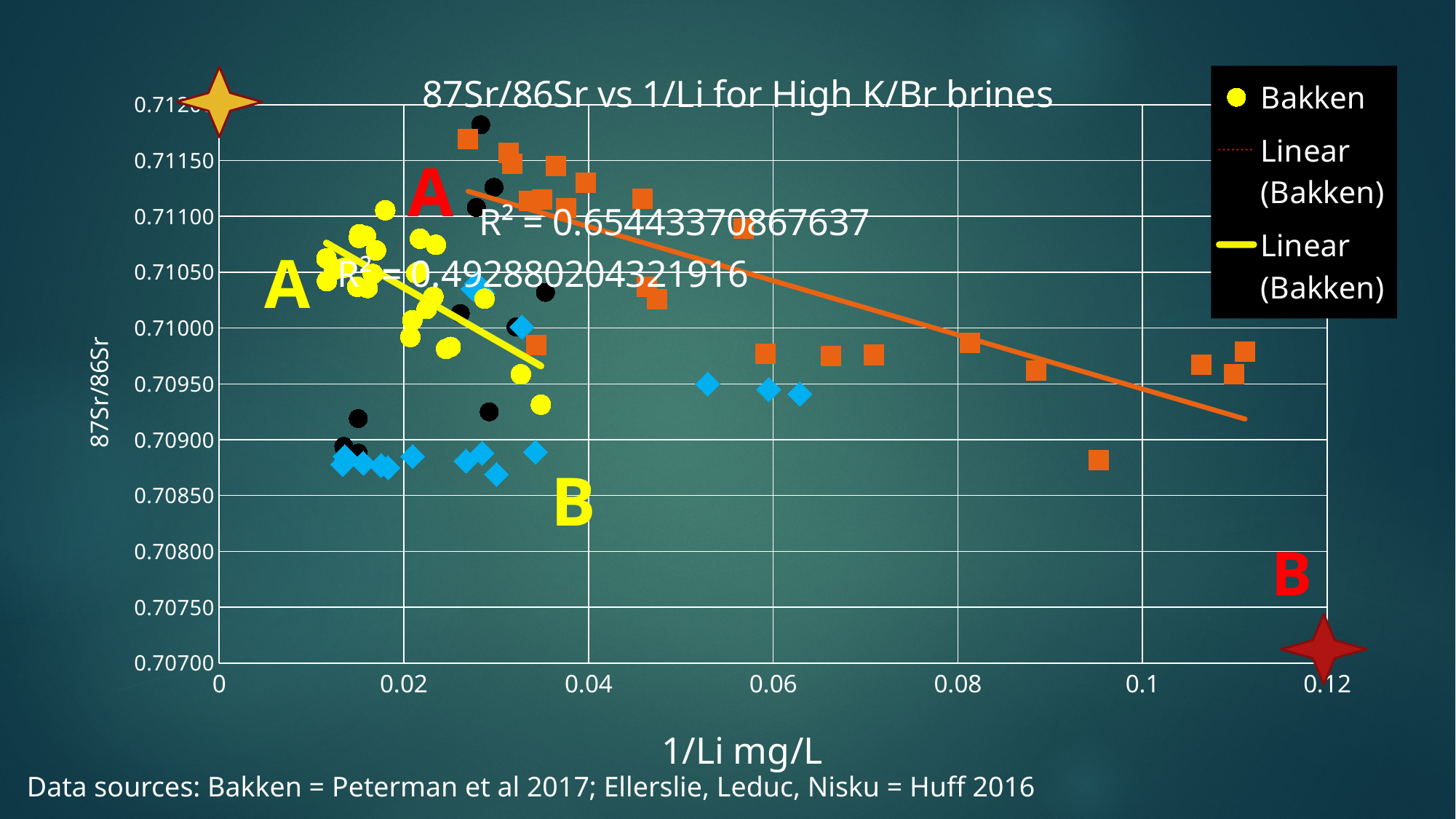
What kind of chart is shown on the slide? Scatter chart What is the R² value printed for the yellow trend line (the lower R² label)? R² = 0.492880204321916 What is the label of the x axis? 1/Li mg/L Is the 87Sr/86Sr value of the highest black circle (near 1/Li = 0.028) greater or less than 0.71150? greater How many entries does the chart legend list? 3 What is the title of the chart? 87Sr/86Sr vs 1/Li for High K/Br brines Which series has the higher 87Sr/86Sr values overall: the orange squares or the blue diamonds? Orange squares Is the 87Sr/86Sr value of the blue diamond plotted near 1/Li = 0.053 greater or less than 0.71000? less Is the 87Sr/86Sr value of the orange square plotted near 1/Li = 0.095 greater or less than 0.70900? less What is the highest value shown on the x axis? 0.12 Do the trend lines rise or fall as 1/Li increases along the x axis? Fall What is the R² value printed for the orange trend line (the upper R² label)? R² = 0.65443370867637